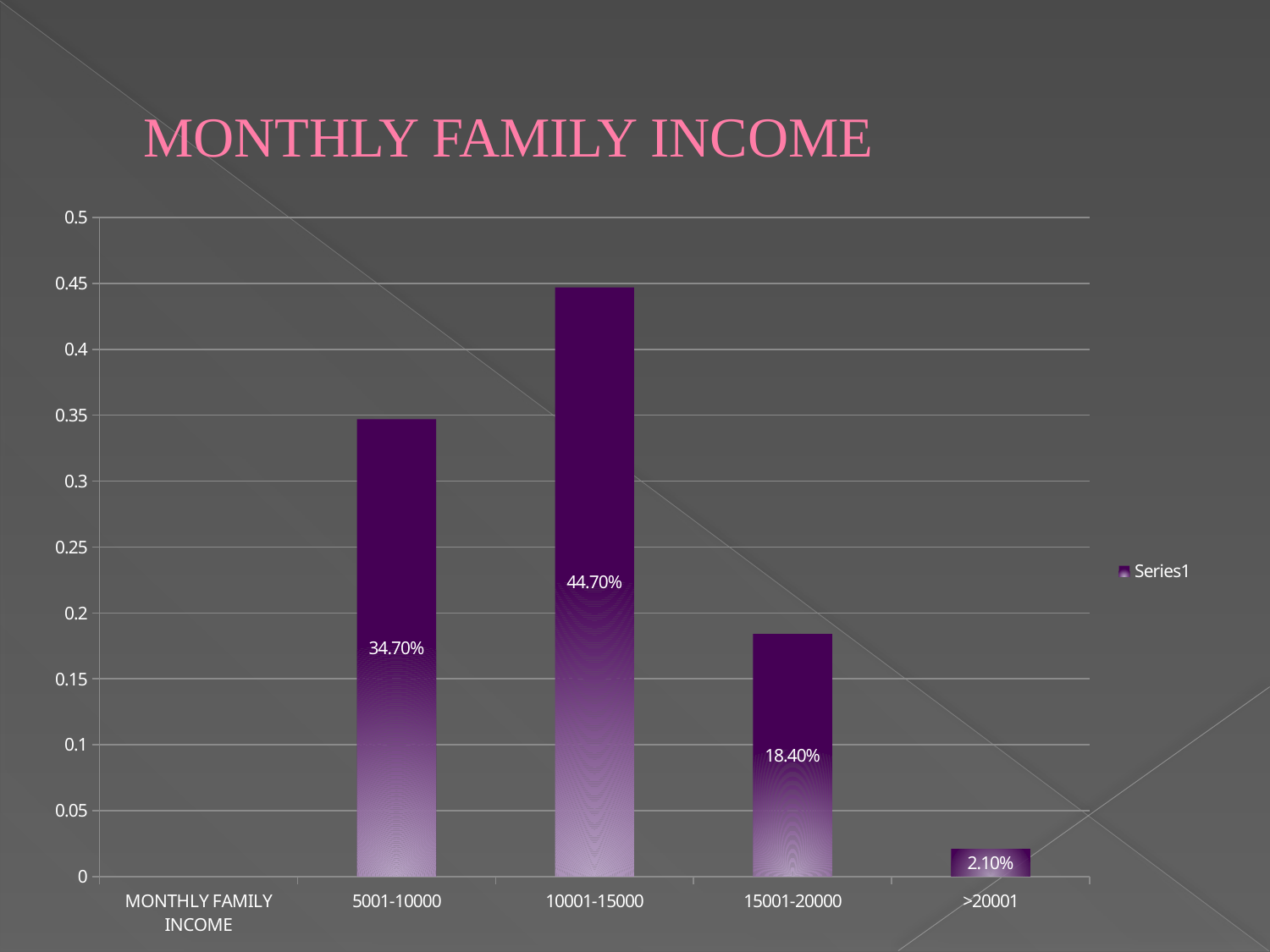
What is the difference between the values for 10001-15000 and 5001-10000? 10.00% What is the difference between the values for 15001-20000 and >20001? 16.30% Is the value for 15001-20000 greater or less than 0.2 on the axis? less What is the value for the 15001-20000 category? 18.40% What is the value for the >20001 category? 2.10% How many bars are plotted in the chart? 4 What is the value for the 5001-10000 category? 34.70% What kind of chart is shown on the slide? Bar chart Which income category has the highest value? 10001-15000 Which income category has the lowest value? >20001 What is the value for the 10001-15000 category? 44.70% Which is larger, the value for 5001-10000 or the value for 15001-20000? 5001-10000